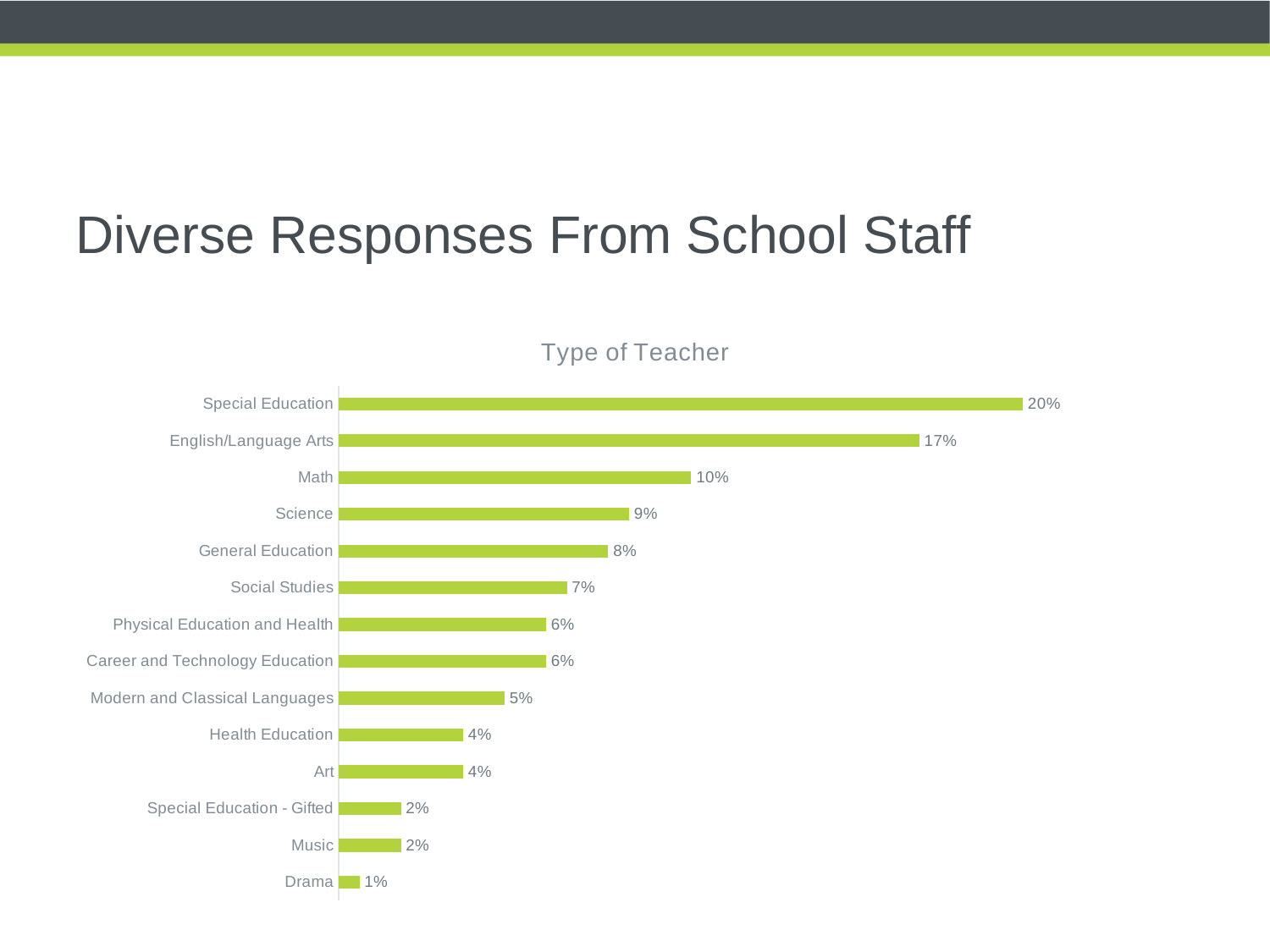
How many types of teacher are shown in the chart? 14 What is the value for Math? 10% Which type of teacher has the highest value? Special Education What is the difference between the values for Science and Art? 5% Which type of teacher has the lowest value? Drama What kind of chart is shown on the slide? Bar chart What is the title of the chart? Type of Teacher What is the value for Special Education? 20% What is the difference between the values for Special Education and English/Language Arts? 3% Which is larger, the value for General Education or the value for Social Studies? General Education What is the value for Modern and Classical Languages? 5% What colour are the bars in the chart? Green